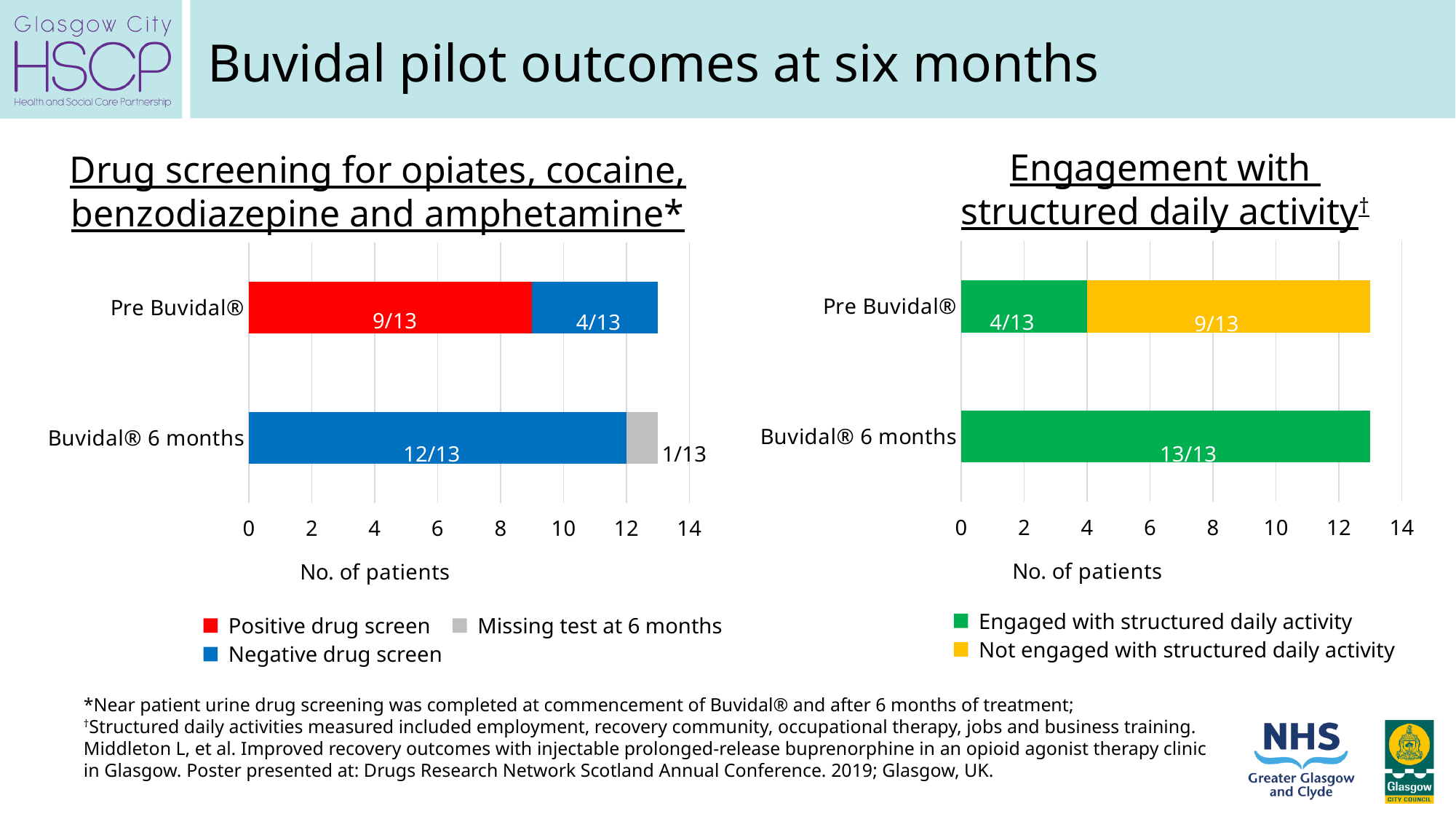
In the 'Engagement with structured daily activity' chart, what is the value for Not engaged with structured daily activity at Pre Buvidal®? 9/13 In the 'Engagement with structured daily activity' chart, what is the value for Engaged with structured daily activity at Buvidal® 6 months? 13/13 In the 'Engagement with structured daily activity' chart, how many series does the legend list? 2 In the 'Drug screening' chart, which is larger: Negative drug screen at Pre Buvidal® or Negative drug screen at Buvidal® 6 months? Buvidal® 6 months In the 'Drug screening' chart, how many series does the legend list? 3 What kind of chart is the 'Drug screening' chart? Stacked bar chart In the 'Engagement with structured daily activity' chart, what is the value for Engaged with structured daily activity at Pre Buvidal®? 4/13 In the 'Drug screening' chart, what is the value for Positive drug screen at Pre Buvidal®? 9/13 In the 'Engagement with structured daily activity' chart, how many categories are shown on the y axis? 2 In the 'Drug screening' chart, what is the value for Negative drug screen at Buvidal® 6 months? 12/13 In the 'Engagement with structured daily activity' chart, what colour represents Not engaged with structured daily activity? Yellow In the 'Drug screening' chart, what is the value for Missing test at 6 months for Buvidal® 6 months? 1/13